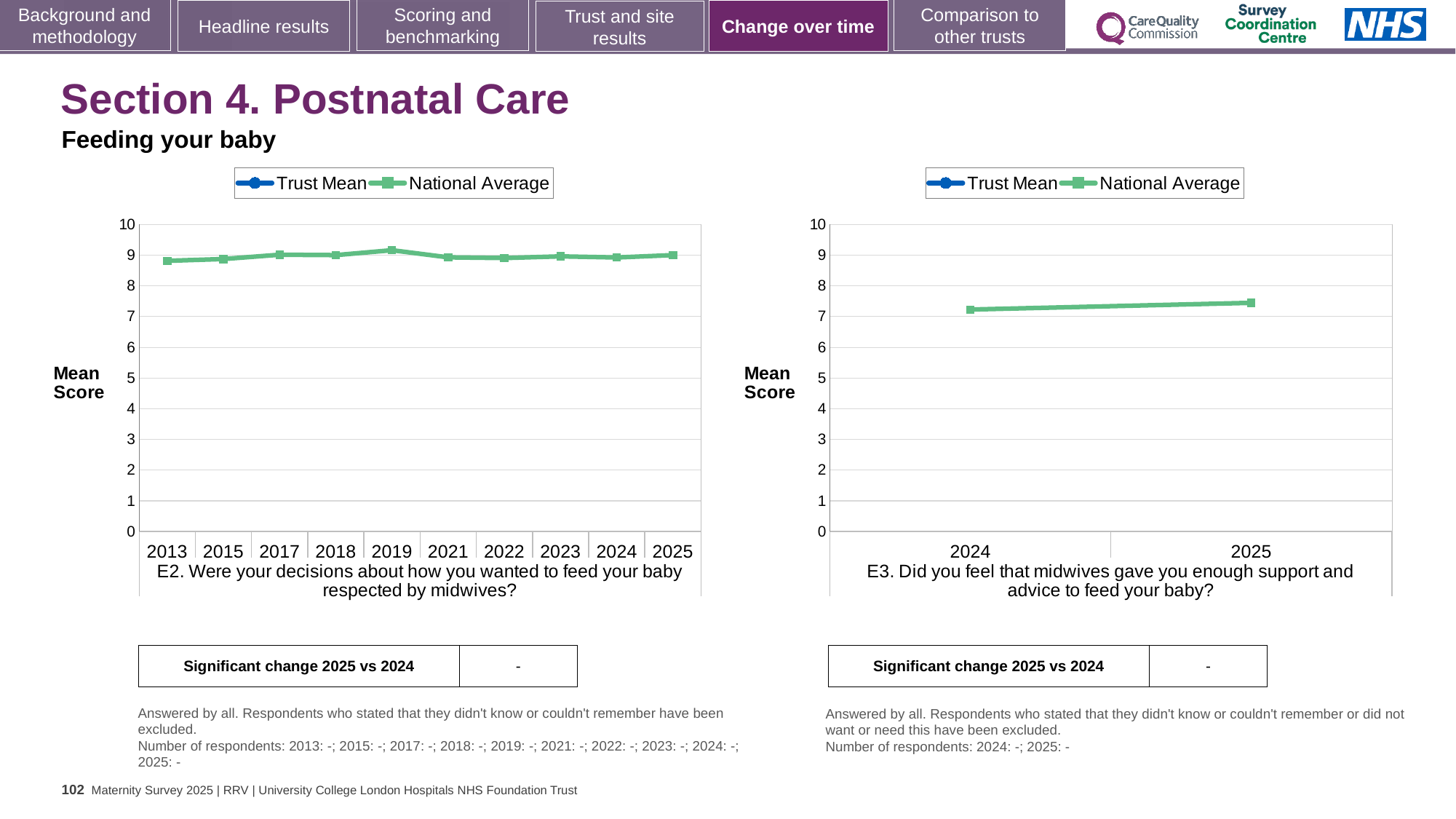
In the left chart (E2), is the National Average value for 2019 greater or less than 9? greater What kind of chart is the left chart (E2. Were your decisions about how you wanted to feed your baby respected by midwives?)? line chart What is the label of the y axis on the left chart (E2)? Mean Score In the right chart (E3), is the National Average value for 2025 greater or less than 8? less In the left chart (E2), is the National Average value for 2013 greater or less than 8? greater How many series does the legend of the left chart (E2) list? 2 In the right chart (E3), is the National Average higher in 2024 or 2025? 2025 In the right chart (E3), does the National Average rise or fall from 2024 to 2025? rise What kind of chart is the right chart (E3. Did you feel that midwives gave you enough support and advice to feed your baby?)? line chart How many years are shown on the x axis of the right chart (E3)? 2 How many years are shown on the x axis of the left chart (E2)? 10